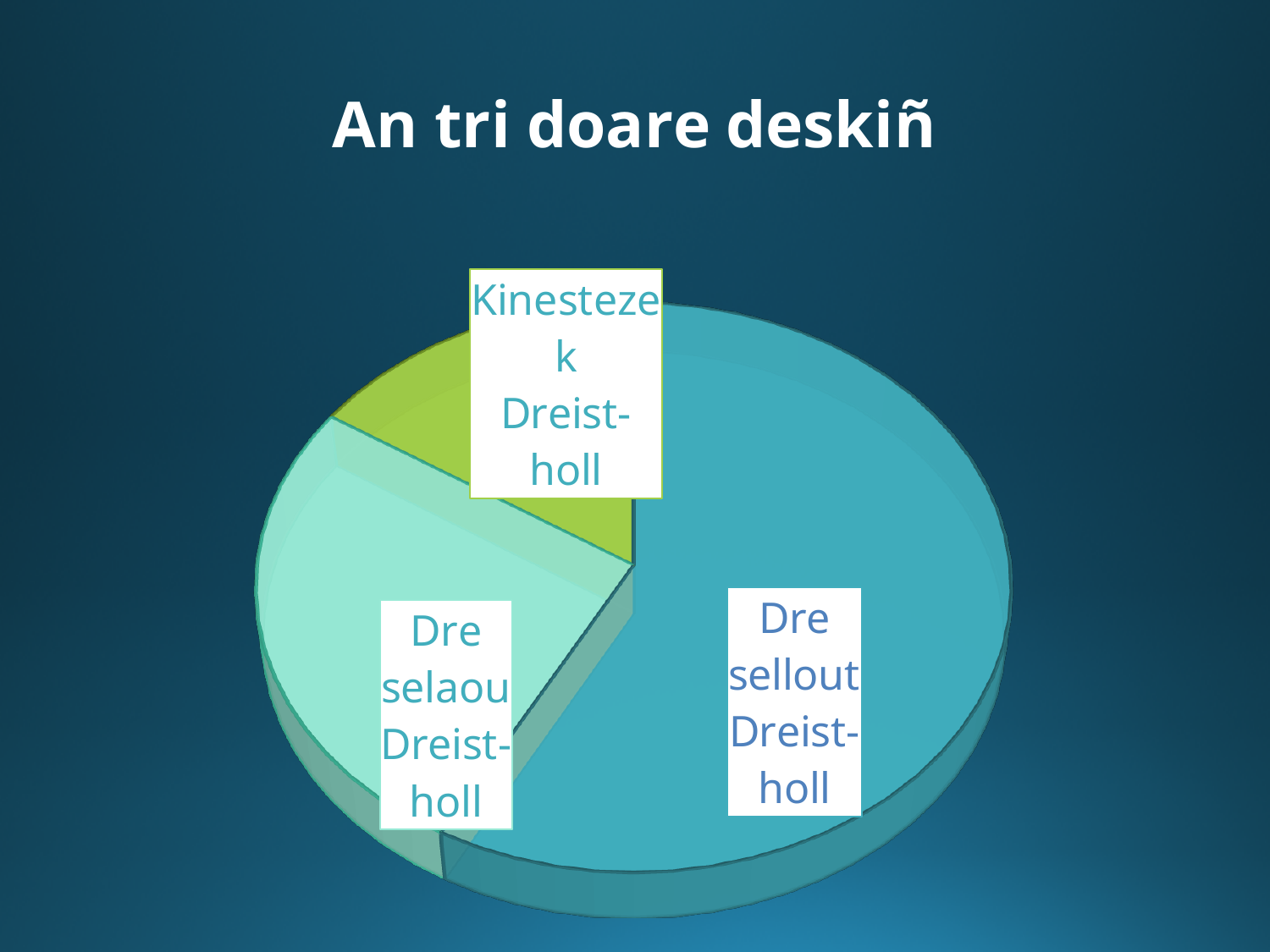
What is the title of the slide containing the pie chart? An tri doare deskiñ Which slice is larger, Dre selaou Dreist-holl or Kinestezek Dreist-holl? Dre selaou Dreist-holl What kind of chart is shown on the slide? pie chart Which slice is larger, Dre sellout Dreist-holl or Dre selaou Dreist-holl? Dre sellout Dreist-holl Which slice of the pie chart is the smallest? Kinestezek Dreist-holl Which slice of the pie chart is the largest? Dre sellout Dreist-holl How many slices does the pie chart have? 3 What colour is the Kinestezek Dreist-holl slice of the pie chart? green